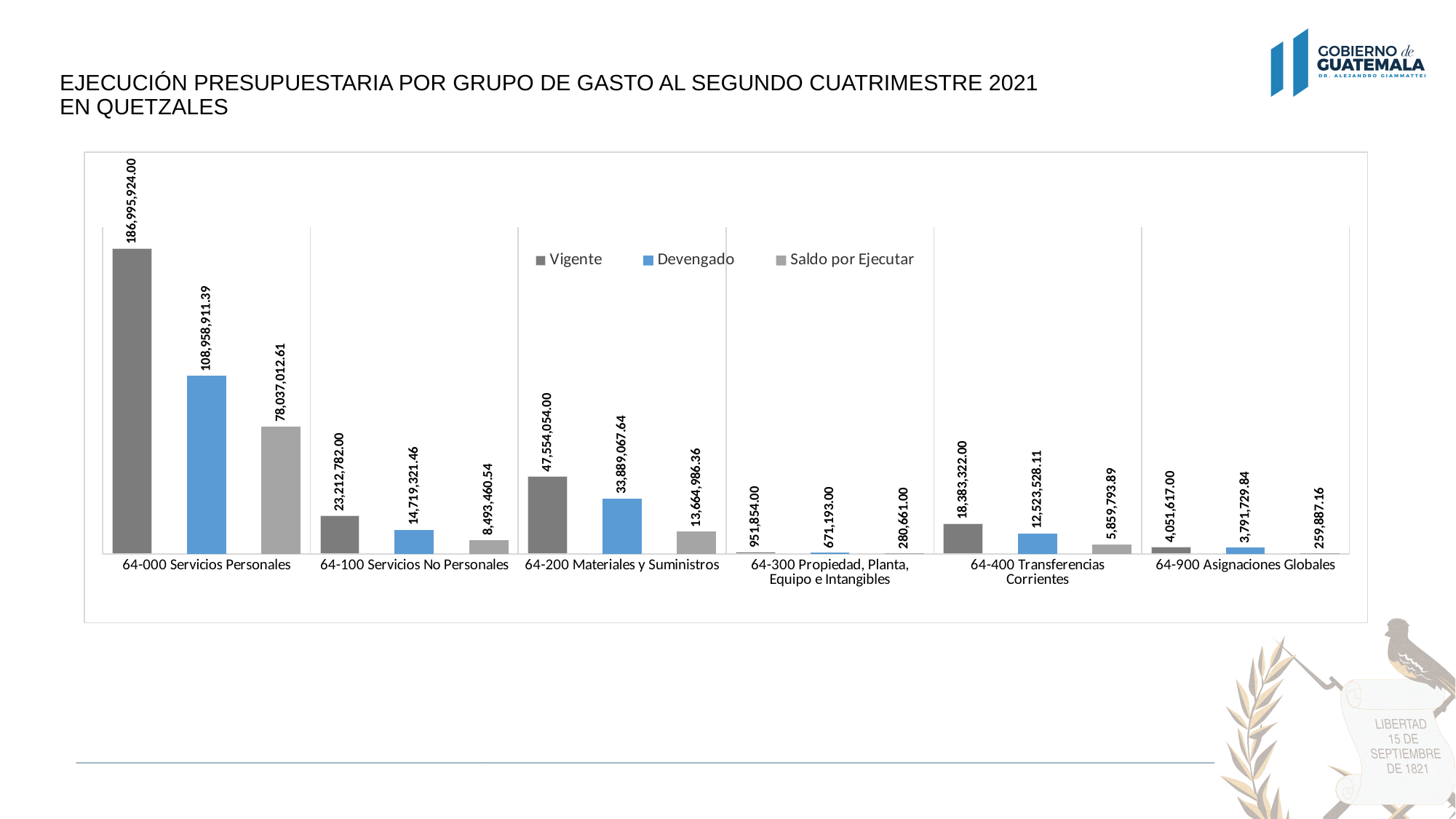
Which category has the highest Vigente value? 64-000 Servicios Personales What is the Saldo por Ejecutar value for 64-400 Transferencias Corrientes? 5,859,793.89 What is the Devengado value for 64-900 Asignaciones Globales? 3,791,729.84 What is the difference between the Vigente and Devengado values for 64-100 Servicios No Personales? 8,493,460.54 Which legend entry is shown in blue? Devengado Which is larger, the Devengado value for 64-200 Materiales y Suministros or the Devengado value for 64-400 Transferencias Corrientes? 64-200 Materiales y Suministros Which category has the lowest Vigente value? 64-300 Propiedad, Planta, Equipo e Intangibles What is the Devengado value for 64-200 Materiales y Suministros? 33,889,067.64 What is the Vigente value for 64-000 Servicios Personales? 186,995,924.00 How many expense group categories are shown on the x axis? 6 What type of chart is shown on the slide? Bar chart How many series does the legend list? 3